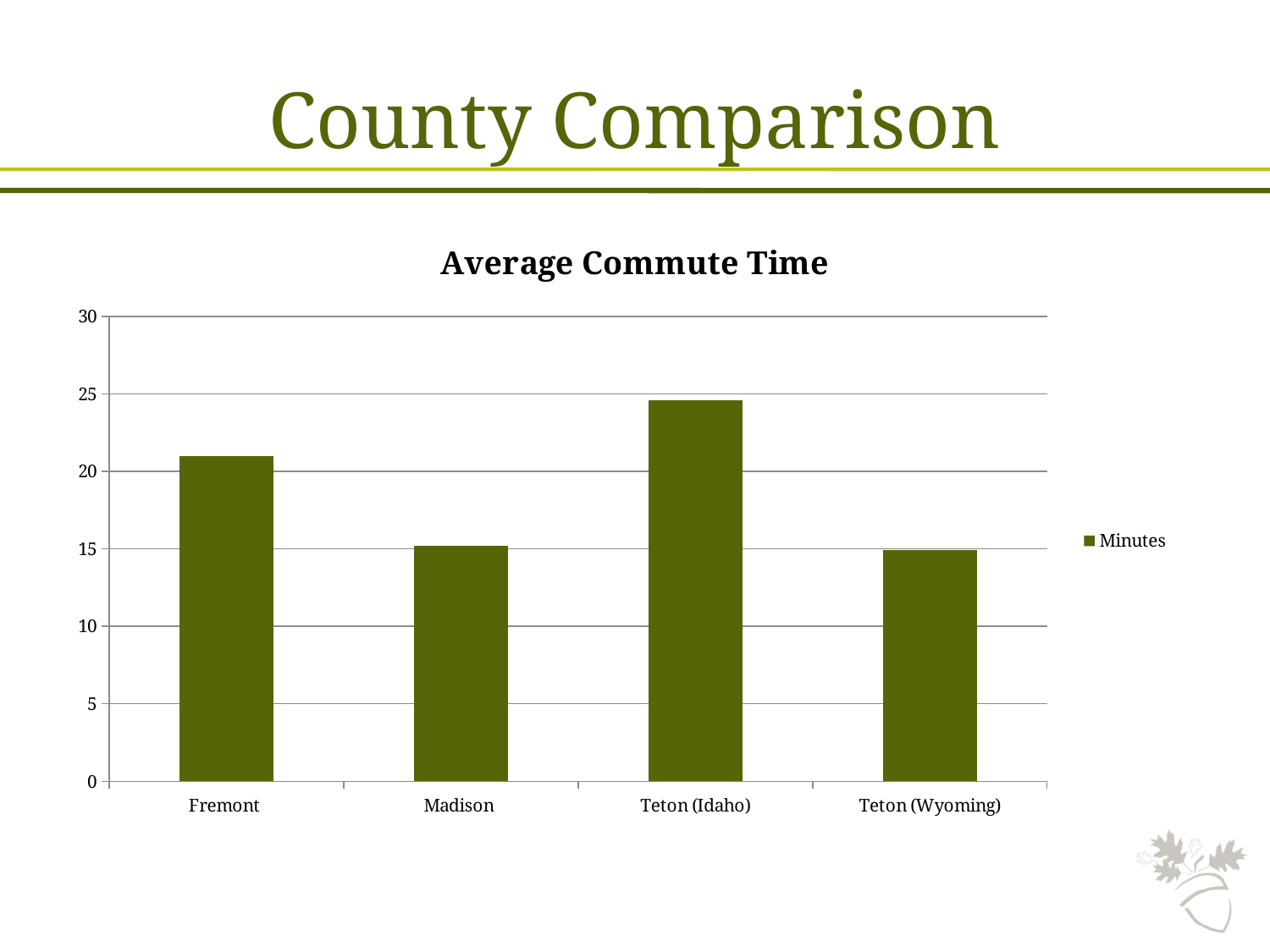
What type of chart is shown on the slide? bar chart Which county has the highest average commute time? Teton (Idaho) Which has a higher average commute time, Fremont or Madison? Fremont Is the value for Madison greater or less than 20? less Is the value for Teton (Wyoming) greater or less than 10? greater What series name does the legend list? Minutes How many series does the legend list? 1 What is the title of the chart? Average Commute Time How many counties are shown on the x axis? 4 Is the value for Fremont greater or less than 20? greater Which has a higher average commute time, Teton (Idaho) or Teton (Wyoming)? Teton (Idaho)